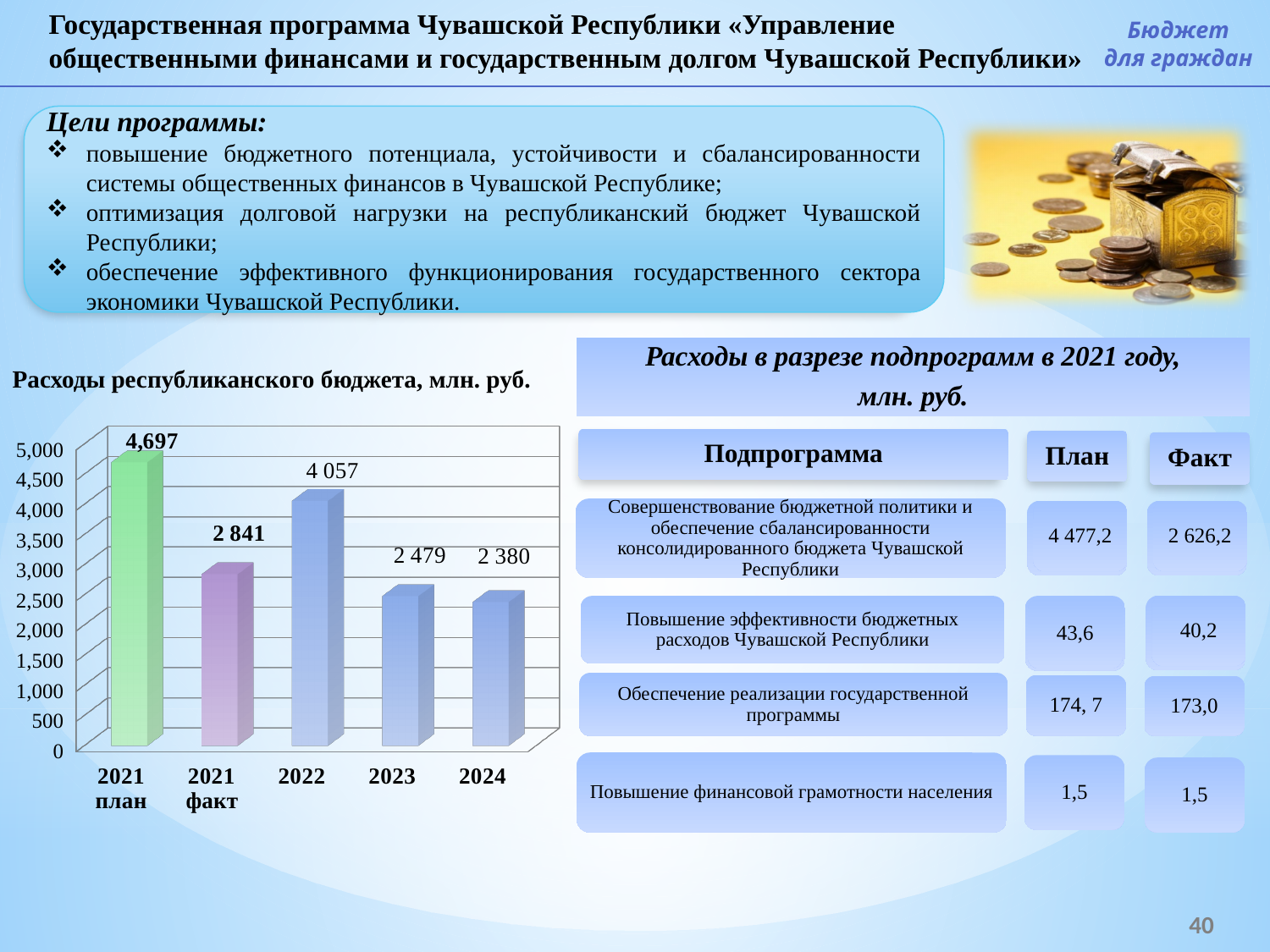
Which category has the highest value in the chart? 2021 план Is the value for 2024 greater or less than 2,500? less What is the value for 2021 факт in the chart? 2 841 Do the values rise or fall from 2022 to 2024? fall How many bars are shown in the chart? 5 What is the value for 2022 in the chart? 4 057 What is the difference between the values for 2022 and 2023? 1 578 What is the value for 2021 план in the chart 'Расходы республиканского бюджета, млн. руб.'? 4,697 What kind of chart is shown on the slide? bar chart Which category has the lowest value in the chart? 2024 What is the value for 2024 in the chart? 2 380 Which is larger, the value for 2021 факт or the value for 2023? 2021 факт